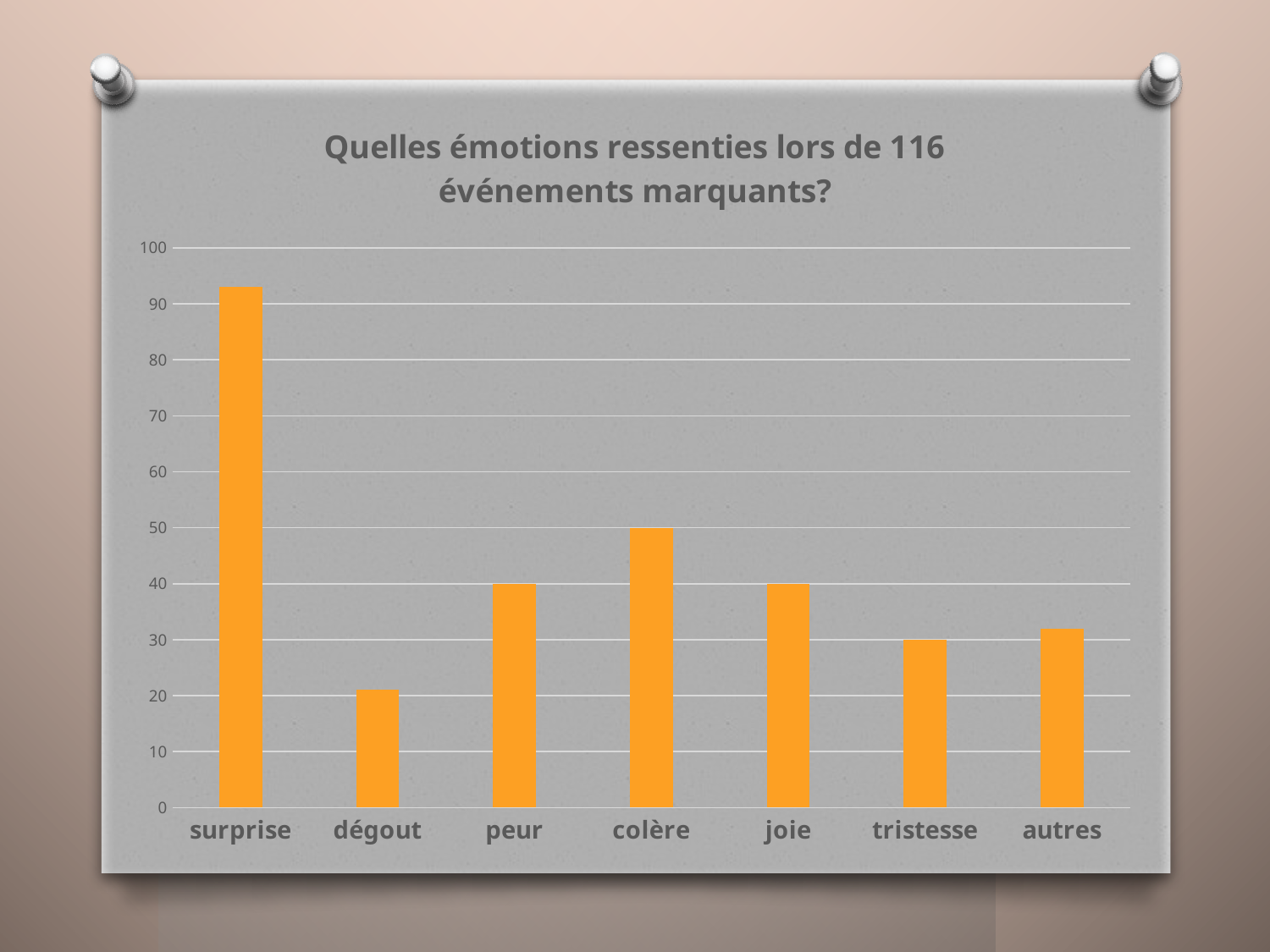
What is the value for colère? 50 Which emotion has the highest bar? surprise Which emotion has the lowest bar? dégout Which is larger, the value for colère or the value for joie? colère What kind of chart is shown on the slide? bar chart Is the value for dégout greater or less than 30? less What is the value for tristesse? 30 What is the title of the chart? Quelles émotions ressenties lors de 116 événements marquants? What is the value for peur? 40 How many emotion categories are plotted on the chart? 7 What is the difference between the values for colère and tristesse? 20 Is the value for surprise greater or less than 90? greater